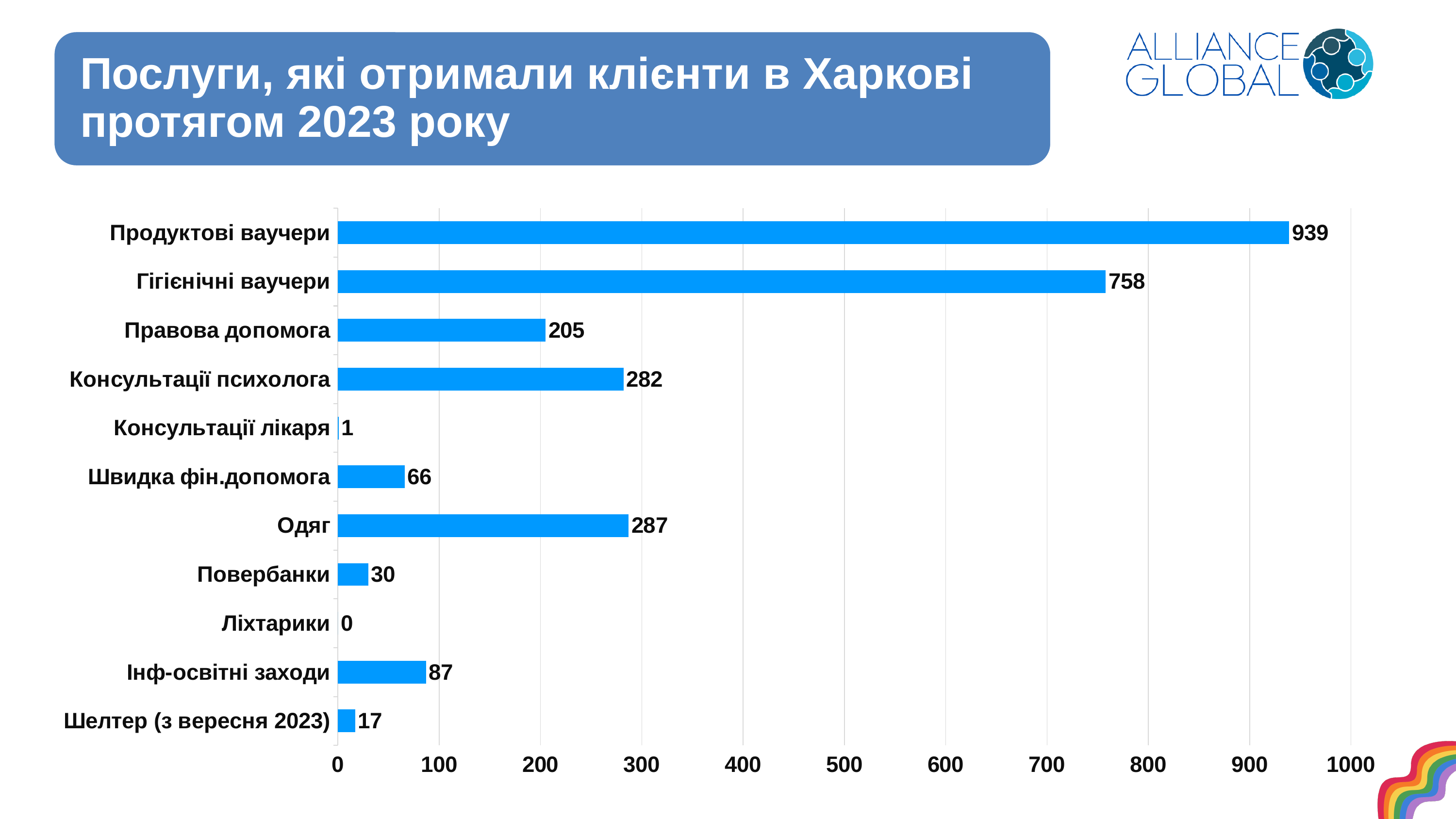
Which category has the lowest value? Ліхтарики What is the title of the slide? Послуги, які отримали клієнти в Харкові протягом 2023 року Which category has the highest value? Продуктові ваучери What is the value for Гігієнічні ваучери? 758 How many categories are shown in the chart? 11 What is the value for Одяг? 287 Is the value for Гігієнічні ваучери greater or less than 700? greater Which is larger, the value for Правова допомога or the value for Консультації психолога? Консультації психолога What kind of chart is shown on the slide? bar chart What is the value for Шелтер (з вересня 2023)? 17 What is the value for Продуктові ваучери? 939 What is the difference between the values for Продуктові ваучери and Гігієнічні ваучери? 181